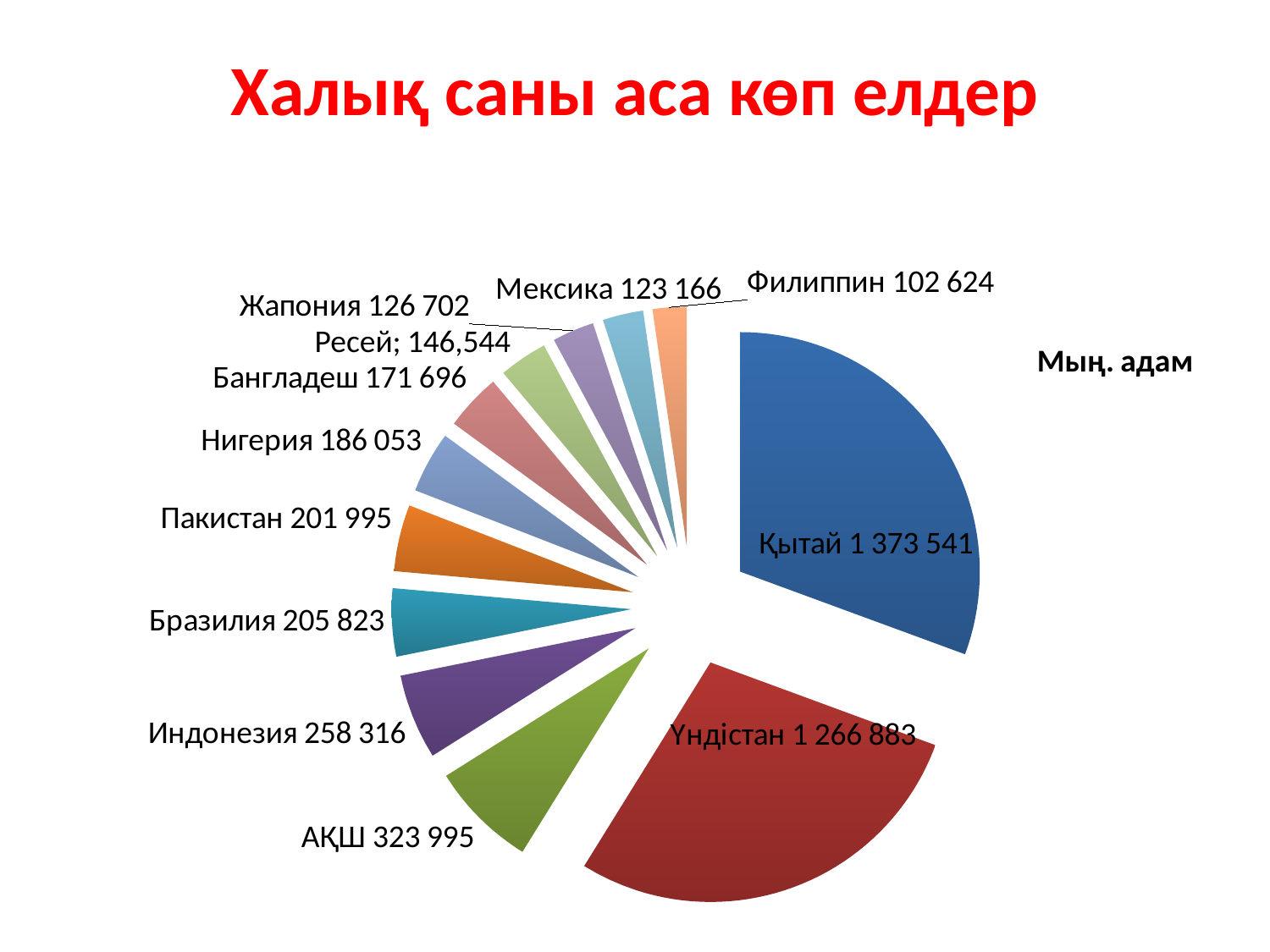
Which country has the largest slice of the pie chart? Қытай What is the difference between the values for Қытай and Үндістан? 106 658 Which country has the smallest slice of the pie chart? Филиппин Which has a larger value, Пакистан or Бангладеш? Пакистан What is the value shown for Нигерия on the pie chart? 186 053 What is the value shown for Индонезия on the pie chart? 258 316 What is the difference between the values for АҚШ and Индонезия? 65 679 How many countries are shown as slices in the pie chart? 12 What is the value shown for Филиппин on the pie chart? 102 624 What type of chart is shown on the slide? Pie chart What is the title of the slide? Халық саны аса көп елдер What is the value shown for Қытай on the pie chart? 1 373 541